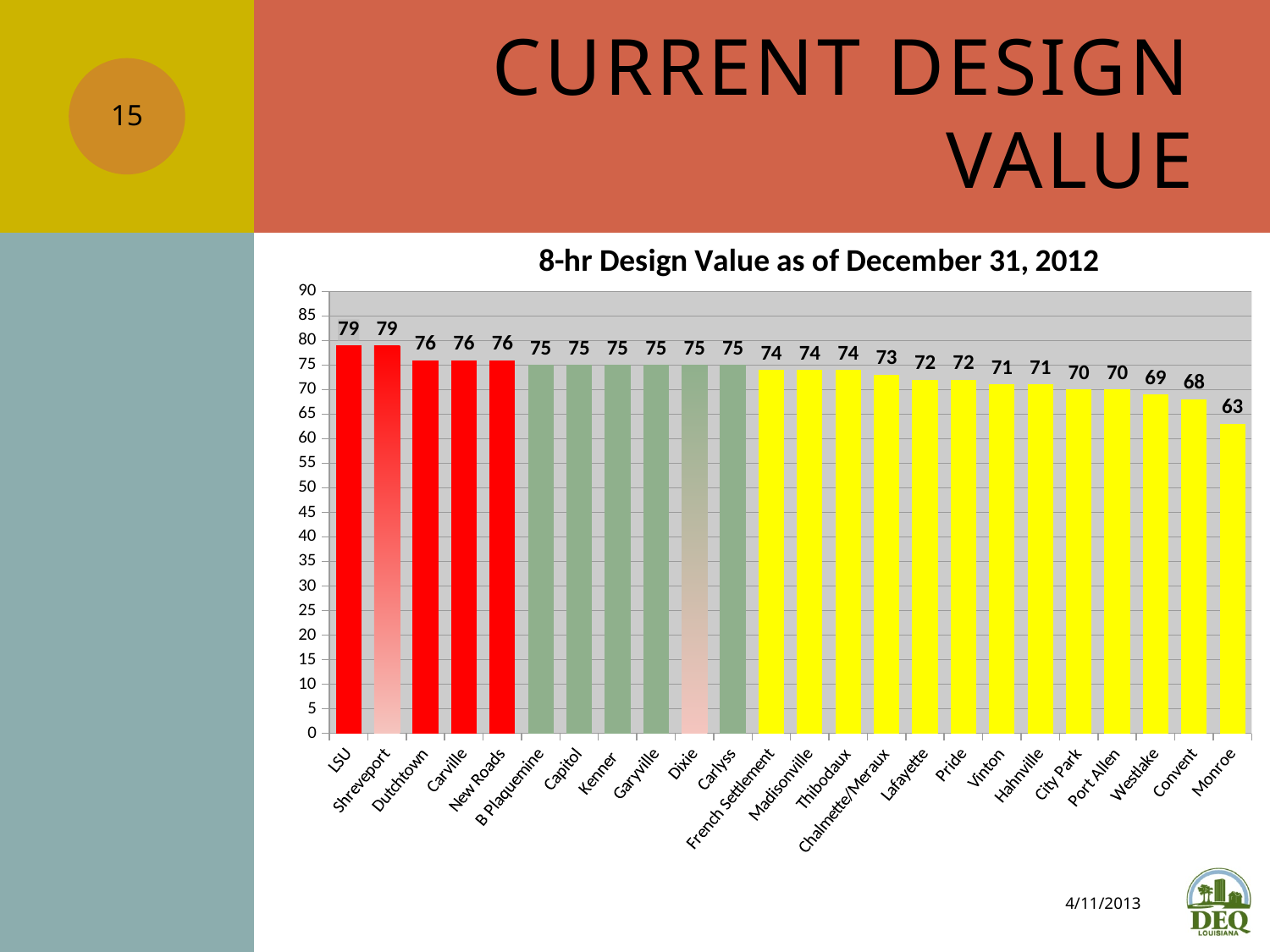
What is the highest 8-hr design value shown on the chart? 79 How many sites are shown on the chart? 24 What type of chart is shown on the slide? Bar chart What is the 8-hr design value for Kenner? 75 What is the 8-hr design value for Monroe? 63 What is the 8-hr design value for Lafayette? 72 What is the difference between the design values for Carville and Convent? 8 Which site has the lowest 8-hr design value? Monroe What is the 8-hr design value for Dutchtown? 76 What is the difference between the design values for LSU and Monroe? 16 Which has a higher design value, Shreveport or Westlake? Shreveport Do the design values rise or fall moving from left to right across the chart? Fall